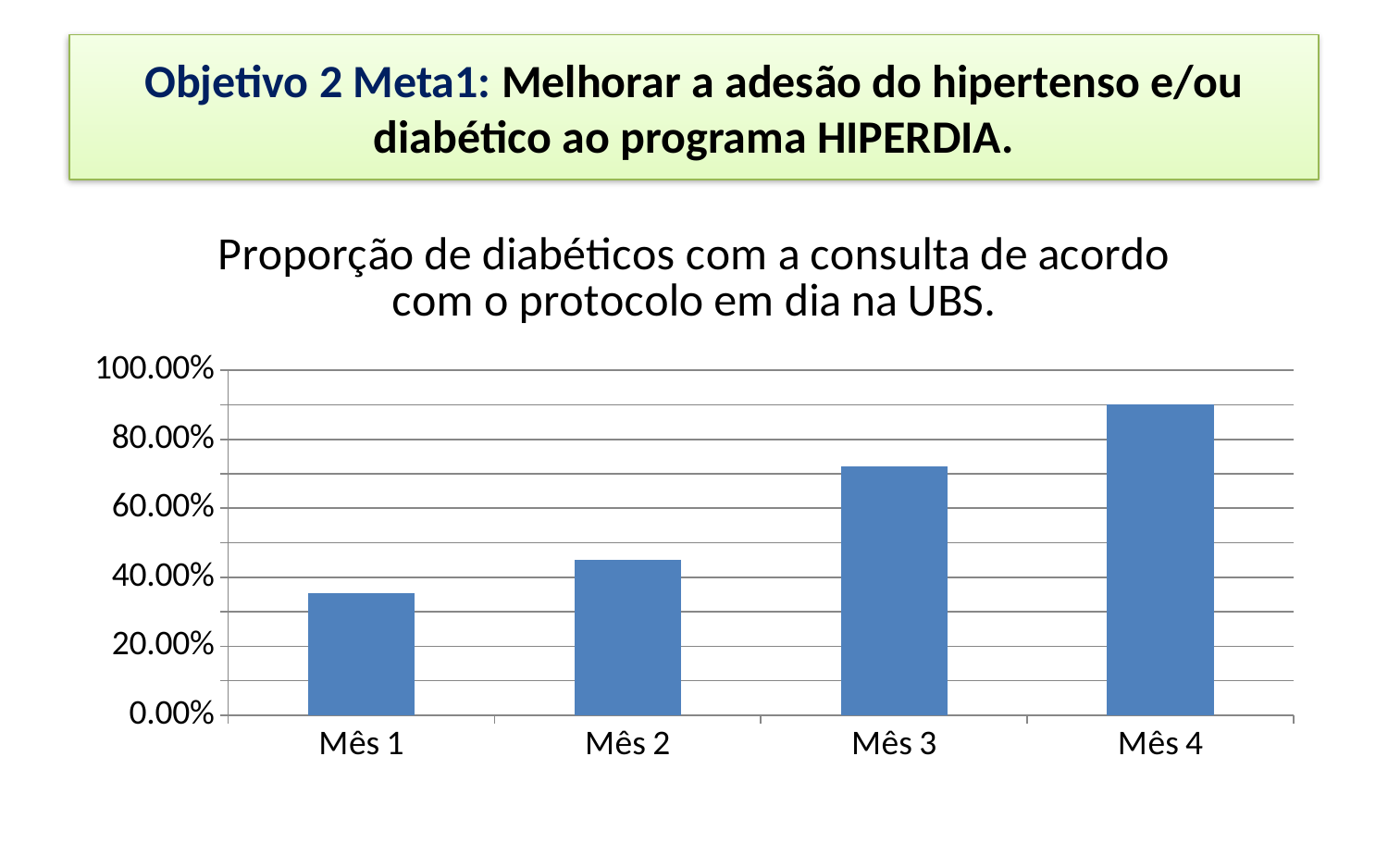
Is the value for Mês 3 greater or less than 80.00%? less Is the value for Mês 4 greater or less than 80.00%? greater What is the title of the chart? Proporção de diabéticos com a consulta de acordo com o protocolo em dia na UBS. Which month has the lowest proportion in the chart? Mês 1 Is the value for Mês 1 greater or less than 40.00%? less Do the values rise or fall from Mês 1 to Mês 4? rise How many categories (months) are shown on the x axis of the chart? 4 What kind of chart is shown on the slide? bar chart Which is larger, the value for Mês 2 or the value for Mês 3? Mês 3 Which month has the highest proportion in the chart? Mês 4